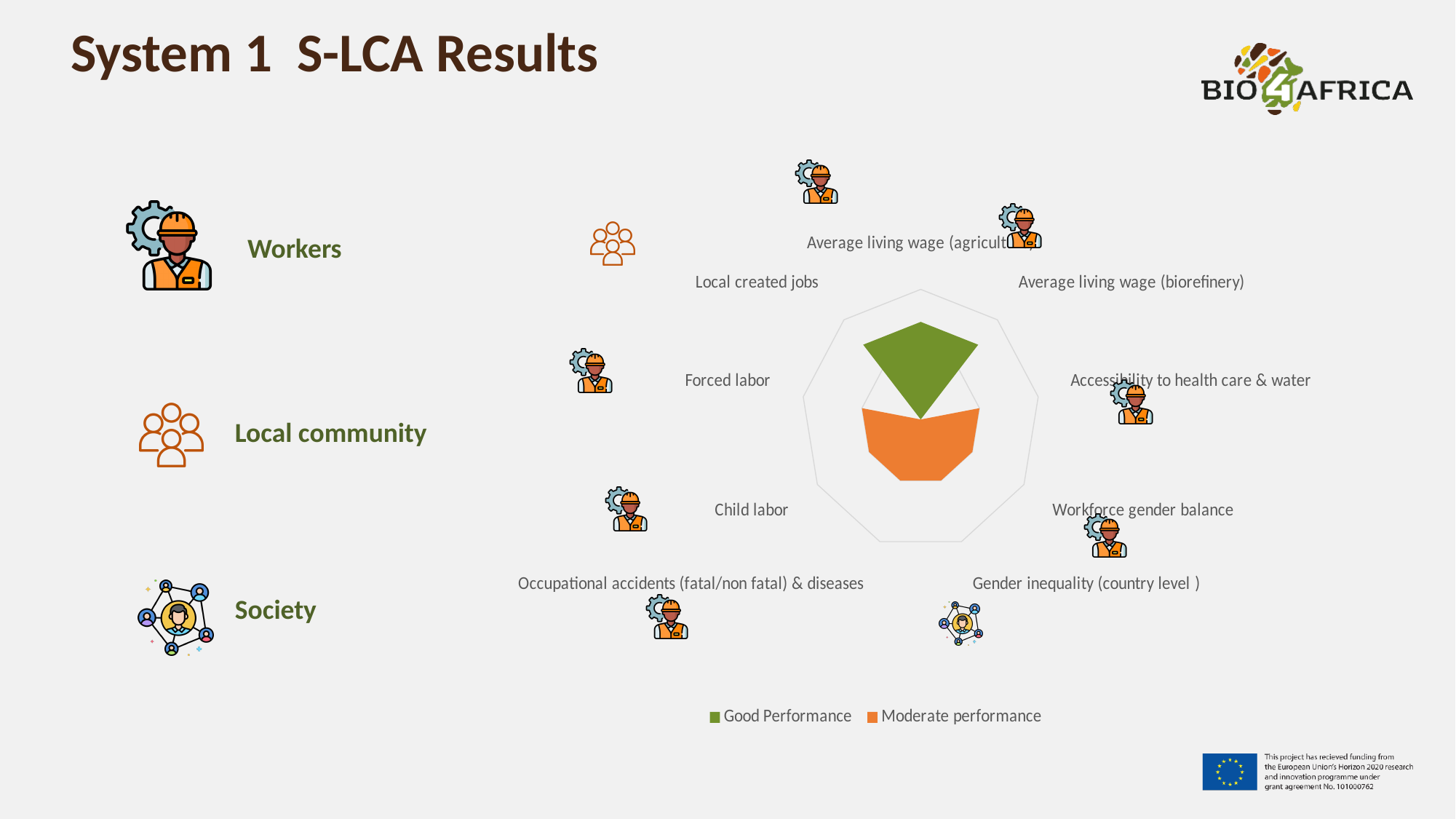
How many categories (axes) does the radar chart have? 9 Is Local created jobs plotted in the Good Performance or the Moderate performance series? Good Performance Which colour represents Good Performance in the chart legend? Green How many series does the chart legend list? 2 Is Average living wage (biorefinery) plotted in the Good Performance or the Moderate performance series? Good Performance What is the title of the slide containing the chart? System 1 S-LCA Results How many categories are covered by the Good Performance (green) area? 3 Is Child labor plotted in the Good Performance or the Moderate performance series? Moderate performance Which series is shown in orange in the chart? Moderate performance Is Forced labor plotted in the Good Performance or the Moderate performance series? Moderate performance How many categories are covered by the Moderate performance (orange) area? 6 What kind of chart is shown on the slide? Radar chart